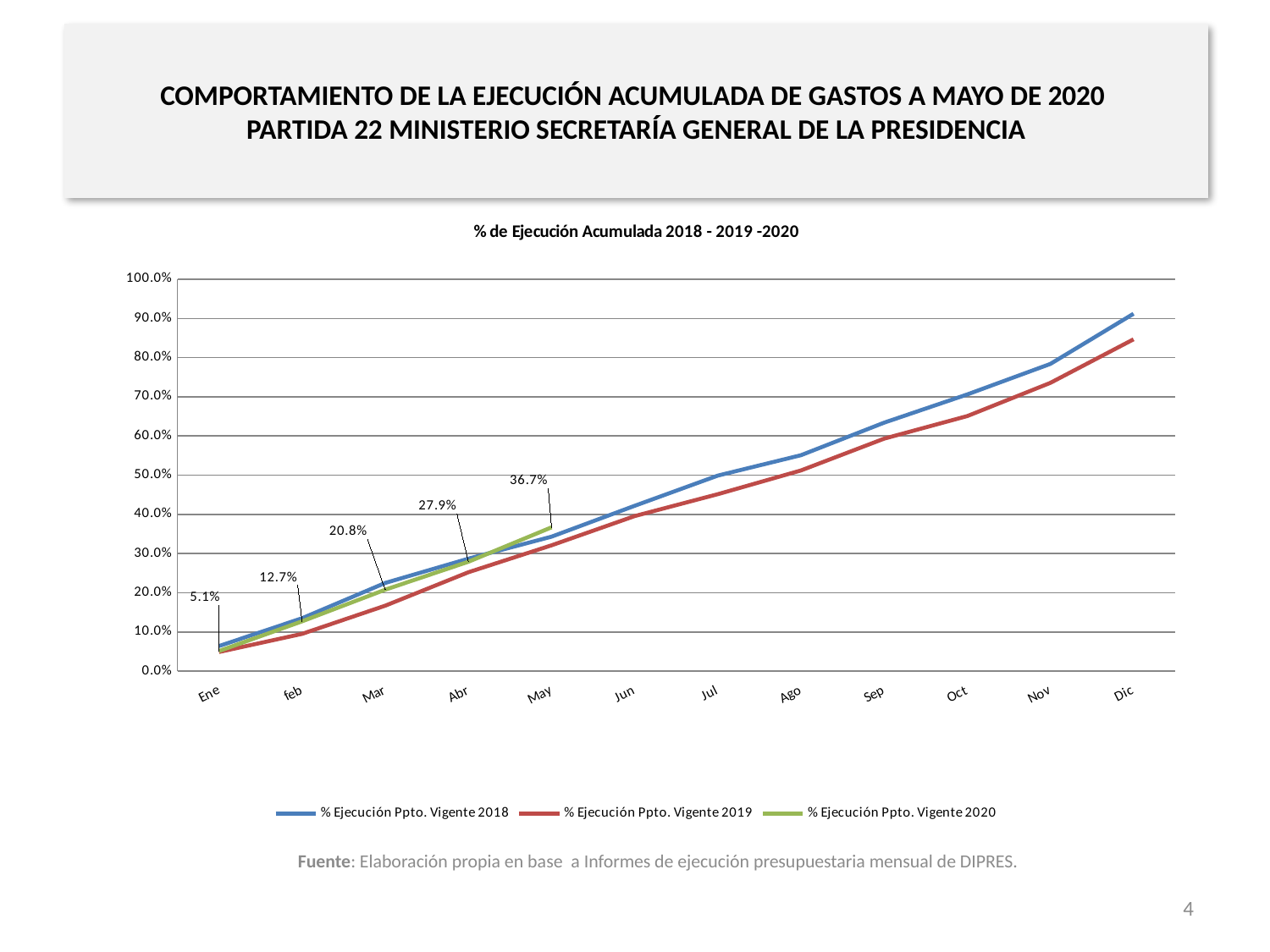
Is the value for % Ejecución Ppto. Vigente 2019 in Dic greater or less than 80%? greater How many months are shown on the x axis? 12 Do the values of the 2018 series rise or fall from Ene to Dic? Rise How many series does the legend list? 3 What is the title of the chart? % de Ejecución Acumulada 2018 - 2019 -2020 By how many percentage points does the 2020 series increase from Abr to May? 8.8 In Dic, which series is higher: % Ejecución Ppto. Vigente 2018 or % Ejecución Ppto. Vigente 2019? % Ejecución Ppto. Vigente 2018 What kind of chart is shown on the slide? Line chart What is the value of % Ejecución Ppto. Vigente 2020 in Mar? 20.8% What is the value of % Ejecución Ppto. Vigente 2020 in May? 36.7% What is the difference between the 2020 values for feb and Ene? 7.6 percentage points What is the value of % Ejecución Ppto. Vigente 2020 in Ene? 5.1%